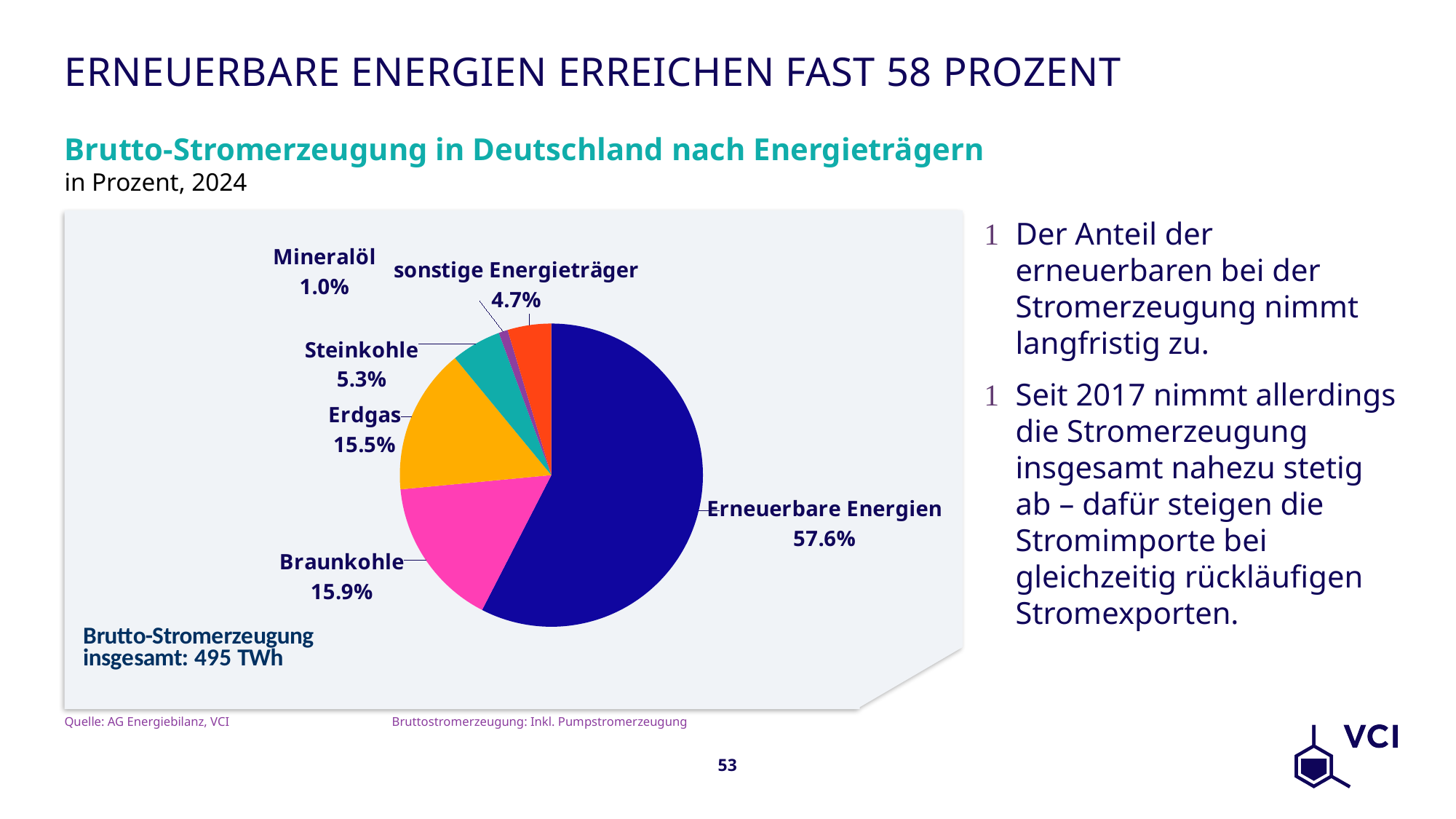
What is the difference in percentage points between Erneuerbare Energien and Braunkohle? 41.7 What is the difference in percentage points between Braunkohle and Erdgas? 0.4 What is the value shown for Erdgas in the pie chart? 15.5% Which energy source has the smallest slice of the pie chart? Mineralöl What percentage is shown for Steinkohle? 5.3% Which energy source has the largest slice of the pie chart? Erneuerbare Energien How many energy source categories are shown in the pie chart? 6 What is the value for Mineralöl in the pie chart? 1.0% What total gross electricity generation is stated in the chart area? 495 TWh What share of gross electricity generation does Erneuerbare Energien have in the pie chart? 57.6% Which has a larger share, Steinkohle or sonstige Energieträger? sonstige Energieträger What type of chart is shown on the slide? Pie chart